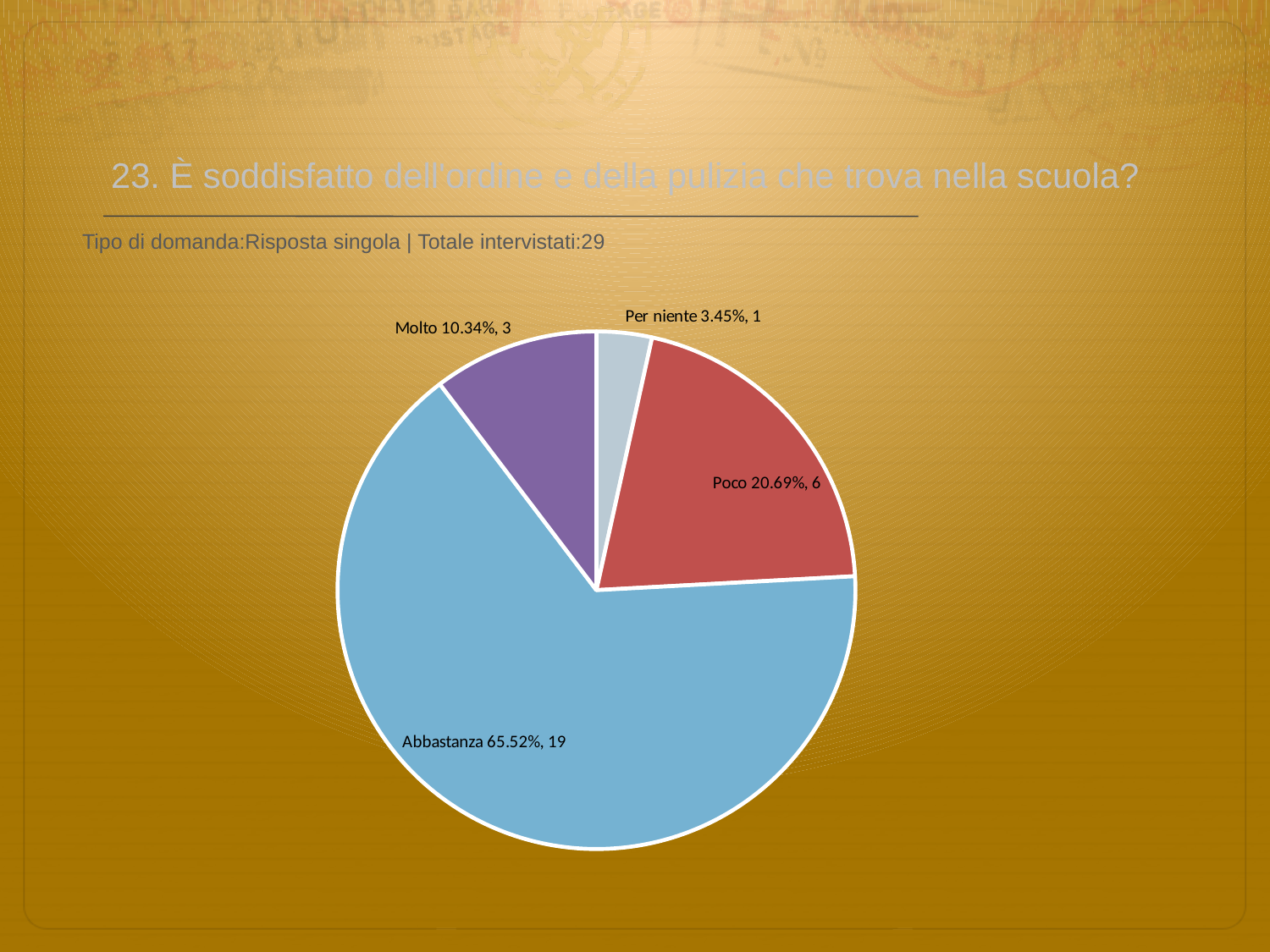
What percentage share does the Abbastanza slice have? 65.52% Which category has the largest slice? Abbastanza What is the difference in respondent count between Abbastanza and Poco? 13 Which has a larger share, Poco or Molto? Poco Which category has the smallest slice? Per niente What colour is the Abbastanza slice? light blue How many respondents answered Poco? 6 What kind of chart is shown on the slide? pie chart How many slices does the pie chart have? 4 What percentage share does the Molto slice have? 10.34% How many respondents answered Per niente? 1 What is the total number of respondents stated on the slide? 29